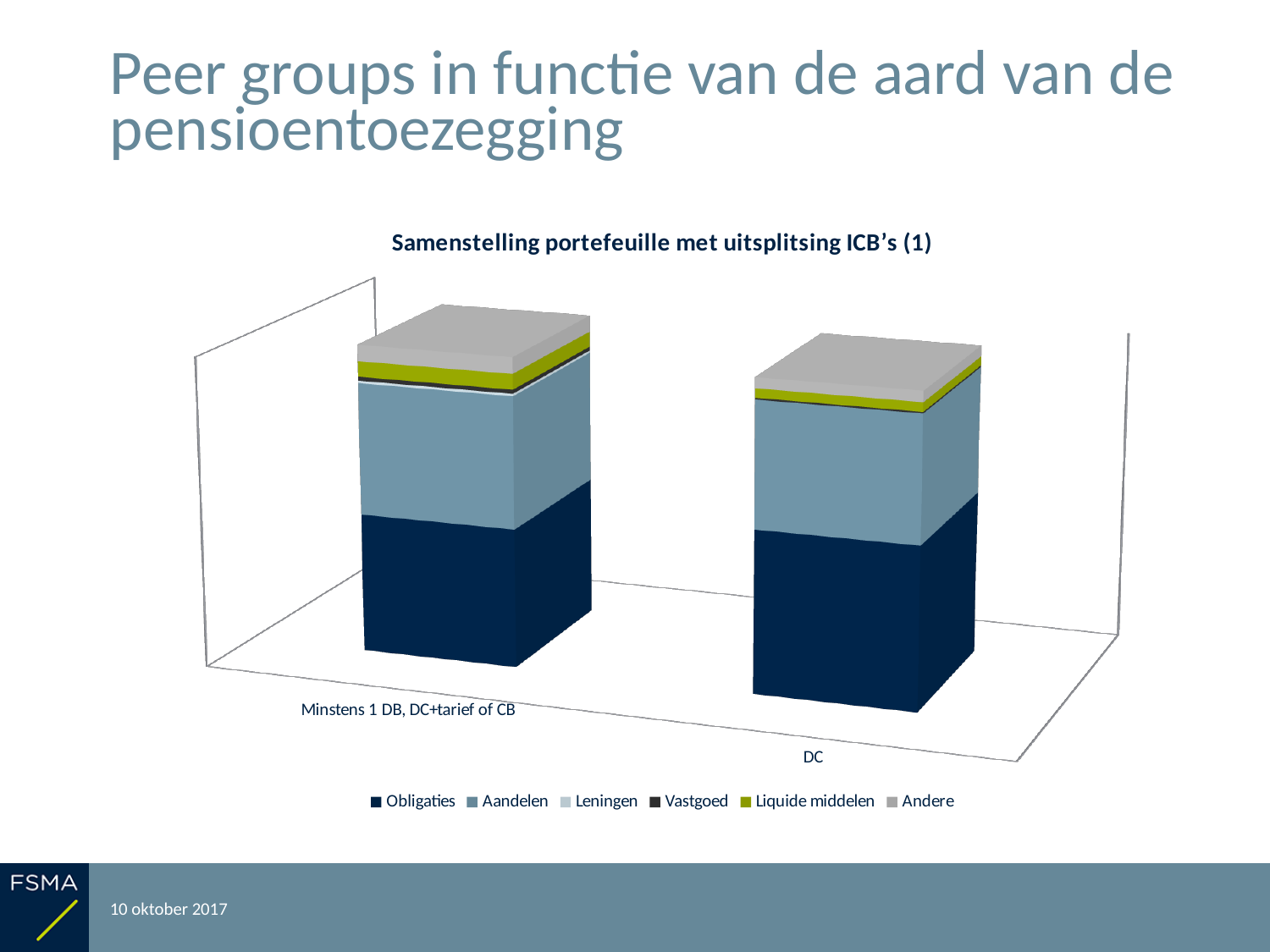
In the 'Minstens 1 DB, DC+tarief of CB' bar, which segment is larger: Obligaties or Liquide middelen? Obligaties Which series is listed first in the chart's legend? Obligaties What kind of chart is shown on the slide? Stacked bar chart In the 'Minstens 1 DB, DC+tarief of CB' bar, which segment is larger: Aandelen or Andere? Aandelen In the DC bar, which segment is larger: Andere or Liquide middelen? Andere How many series does the chart's legend list? 6 How many categories are shown on the x axis of the chart? 2 What is the title of the chart? Samenstelling portefeuille met uitsplitsing ICB's (1)